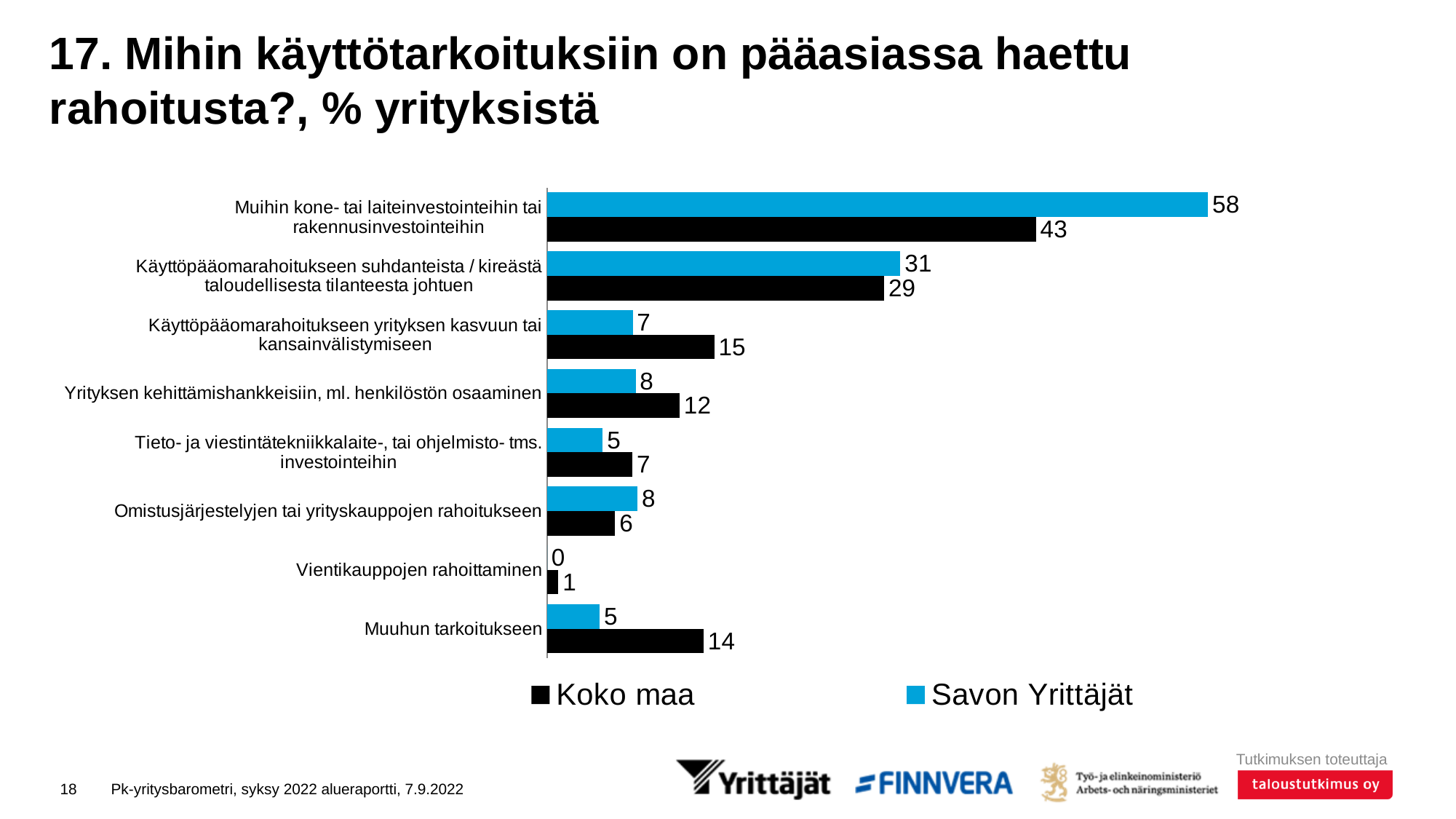
Which is larger for 'Yrityksen kehittämishankkeisiin, ml. henkilöstön osaaminen': Koko maa or Savon Yrittäjät? Koko maa What is the value for Savon Yrittäjät for 'Vientikauppojen rahoittaminen'? 0 What is the value for Koko maa for 'Käyttöpääomarahoitukseen yrityksen kasvuun tai kansainvälistymiseen'? 15 What is the value for Savon Yrittäjät for 'Muihin kone- tai laiteinvestointeihin tai rakennusinvestointeihin'? 58 How many series does the legend list? 2 What kind of chart is shown on the slide? Bar chart What is the value for Koko maa for 'Muuhun tarkoitukseen'? 14 Which category has the lowest value for Savon Yrittäjät? Vientikauppojen rahoittaminen What is the difference between the Savon Yrittäjät and Koko maa values for 'Muihin kone- tai laiteinvestointeihin tai rakennusinvestointeihin'? 15 Which category has the highest value for Koko maa? Muihin kone- tai laiteinvestointeihin tai rakennusinvestointeihin How many categories are shown in the chart? 8 Which is larger for 'Omistusjärjestelyjen tai yrityskauppojen rahoitukseen': Koko maa or Savon Yrittäjät? Savon Yrittäjät